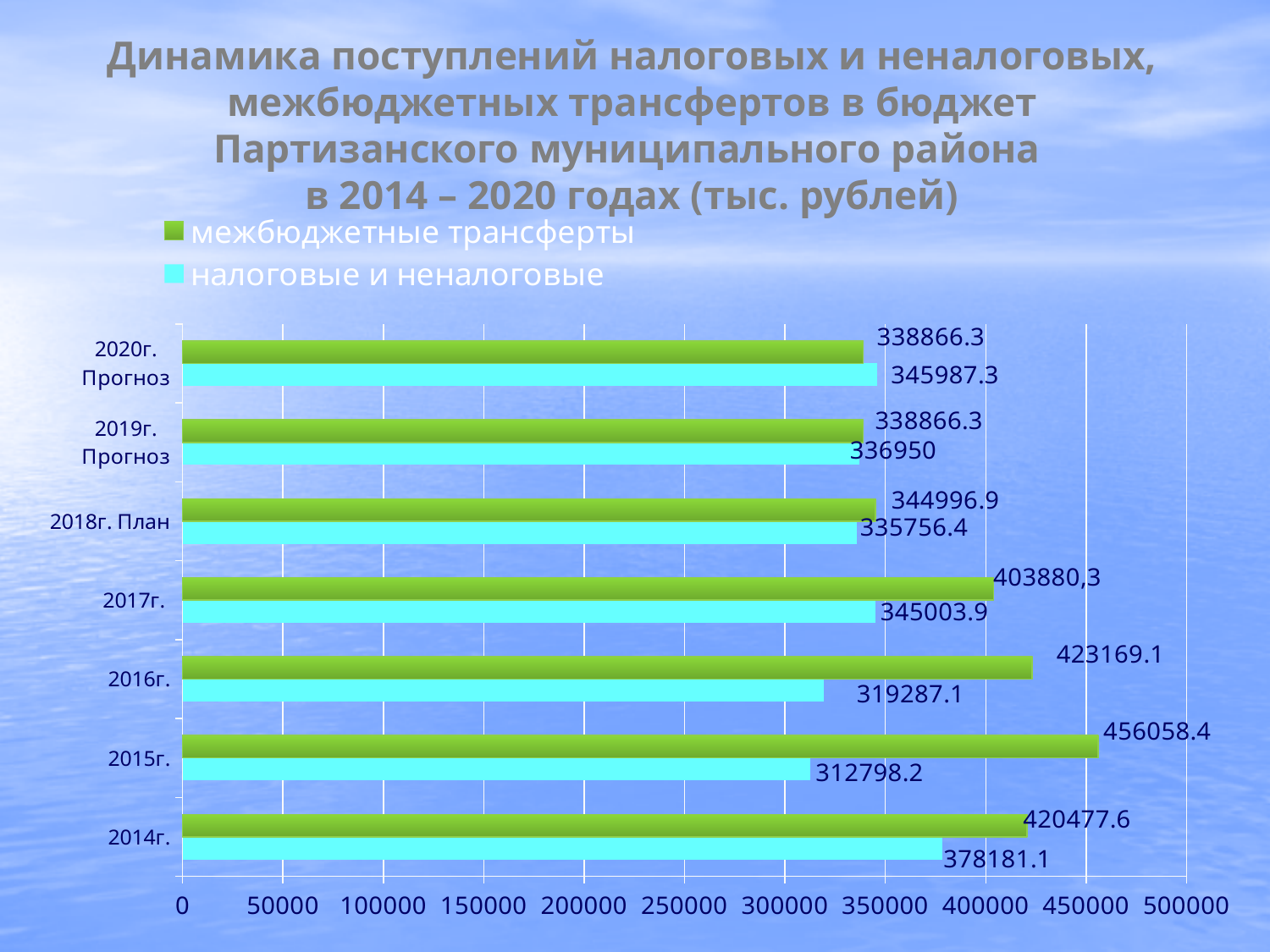
For 2016г., which is larger: межбюджетные трансферты or налоговые и неналоговые? межбюджетные трансферты What is the value of налоговые и неналоговые for 2014г.? 378181.1 What is the value of межбюджетные трансферты for 2017г.? 403880,3 What is the difference between межбюджетные трансферты and налоговые и неналоговые for 2014г.? 42296.5 What is the value of налоговые и неналоговые for 2019г. Прогноз? 336950 What kind of chart is shown on the slide? bar chart Which category has the highest value for межбюджетные трансферты? 2015г. How many categories are shown on the chart? 7 How many series does the legend list? 2 Which category has the lowest value for налоговые и неналоговые? 2015г. What is the value of межбюджетные трансферты for 2015г.? 456058.4 Which category has the highest value for налоговые и неналоговые? 2014г.